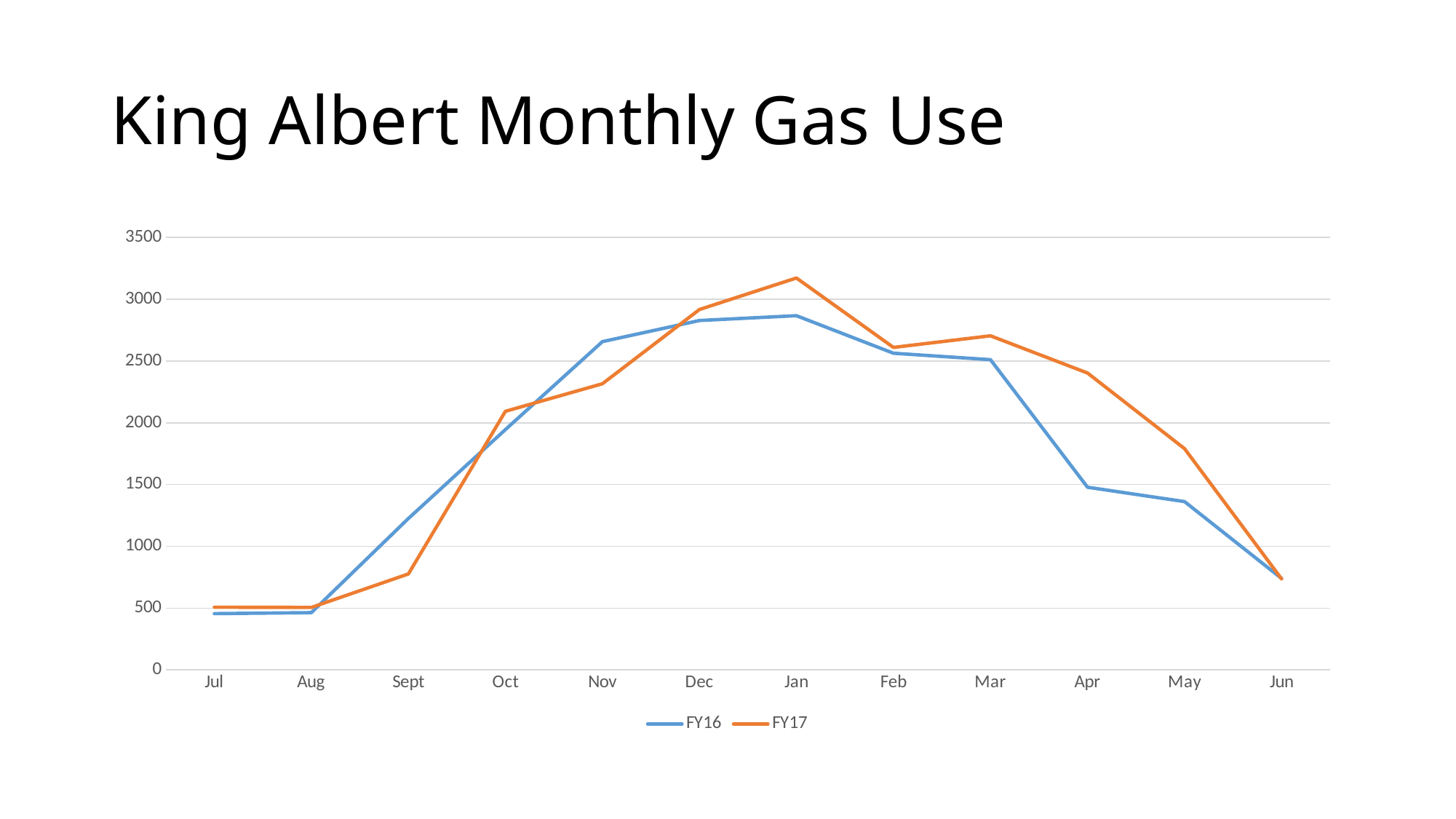
How many months are plotted along the x axis? 12 In Apr, which series has the larger value, FY16 or FY17? FY17 What kind of chart is shown on the slide? line chart In Sept, which series has the larger value, FY16 or FY17? FY16 Is the FY16 value for Nov greater or less than 2500? greater Is the FY16 value for Apr greater or less than 2000? less In which month does the FY17 series reach its highest value? Jan Is the FY17 value for Sept greater or less than 1000? less What is the title of the slide containing the chart? King Albert Monthly Gas Use Does the FY17 series rise or fall from Jan to Jun? fall How many series does the legend list? 2